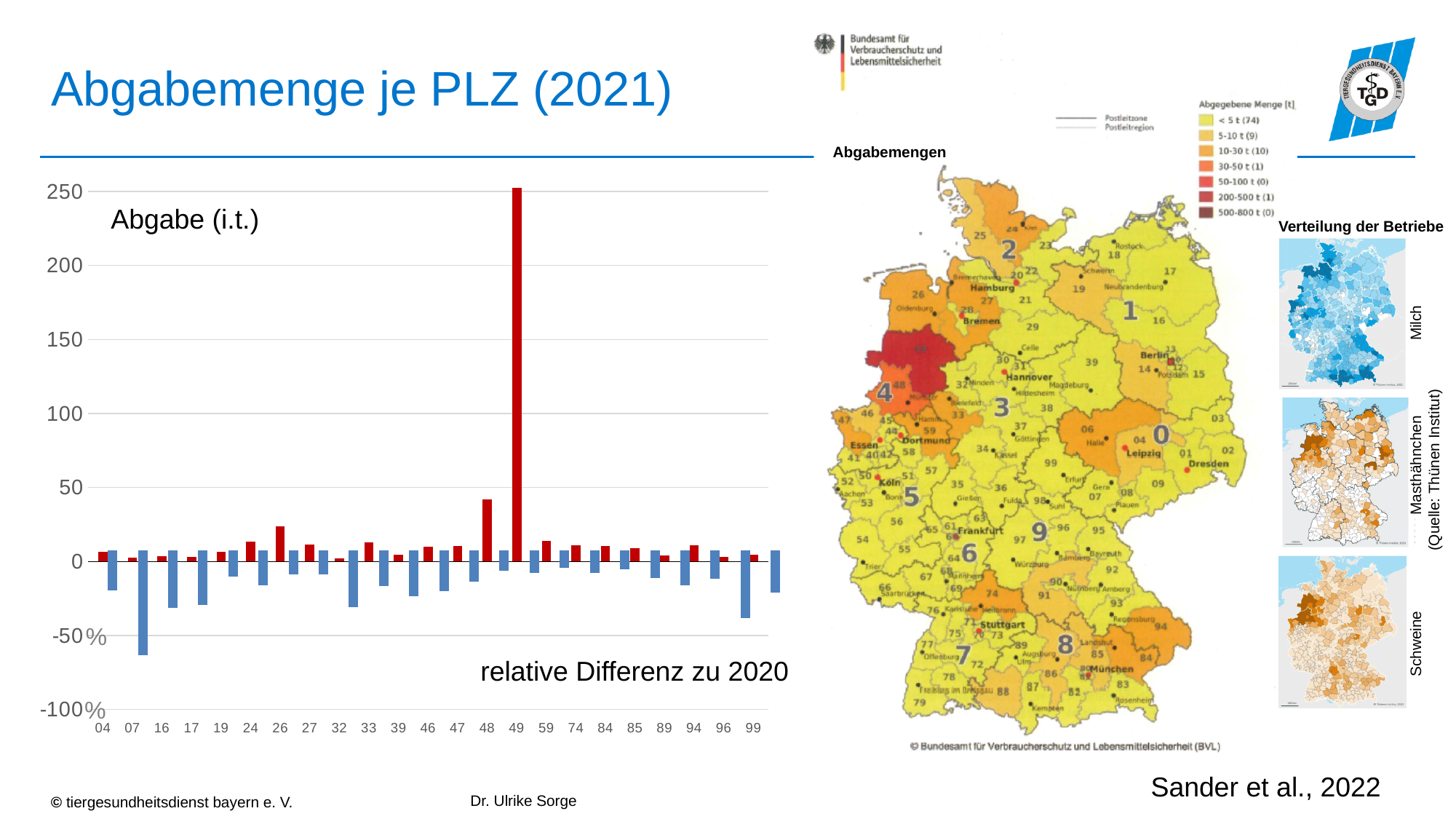
What do the red bars in the bar chart represent? Abgabe (i.t.) How many postcode (PLZ) categories are shown on the x axis of the bar chart? 23 Is the Abgabe (i.t.) value for PLZ 49 greater or less than 200? greater What is the title of the slide containing the bar chart? Abgabemenge je PLZ (2021) Which has the lower relative Differenz zu 2020, PLZ 07 or PLZ 99? 07 Which has the larger Abgabe (i.t.) value, PLZ 48 or PLZ 26? 48 Which PLZ category has the highest Abgabe (i.t.) value in the bar chart? 49 Is the relative Differenz zu 2020 for PLZ 99 greater or less than -50%? greater Which PLZ category has the lowest relative Differenz zu 2020 (blue bars)? 07 What kind of chart is shown on the left of the slide? bar chart Is the relative Differenz zu 2020 for PLZ 07 greater or less than -50%? less